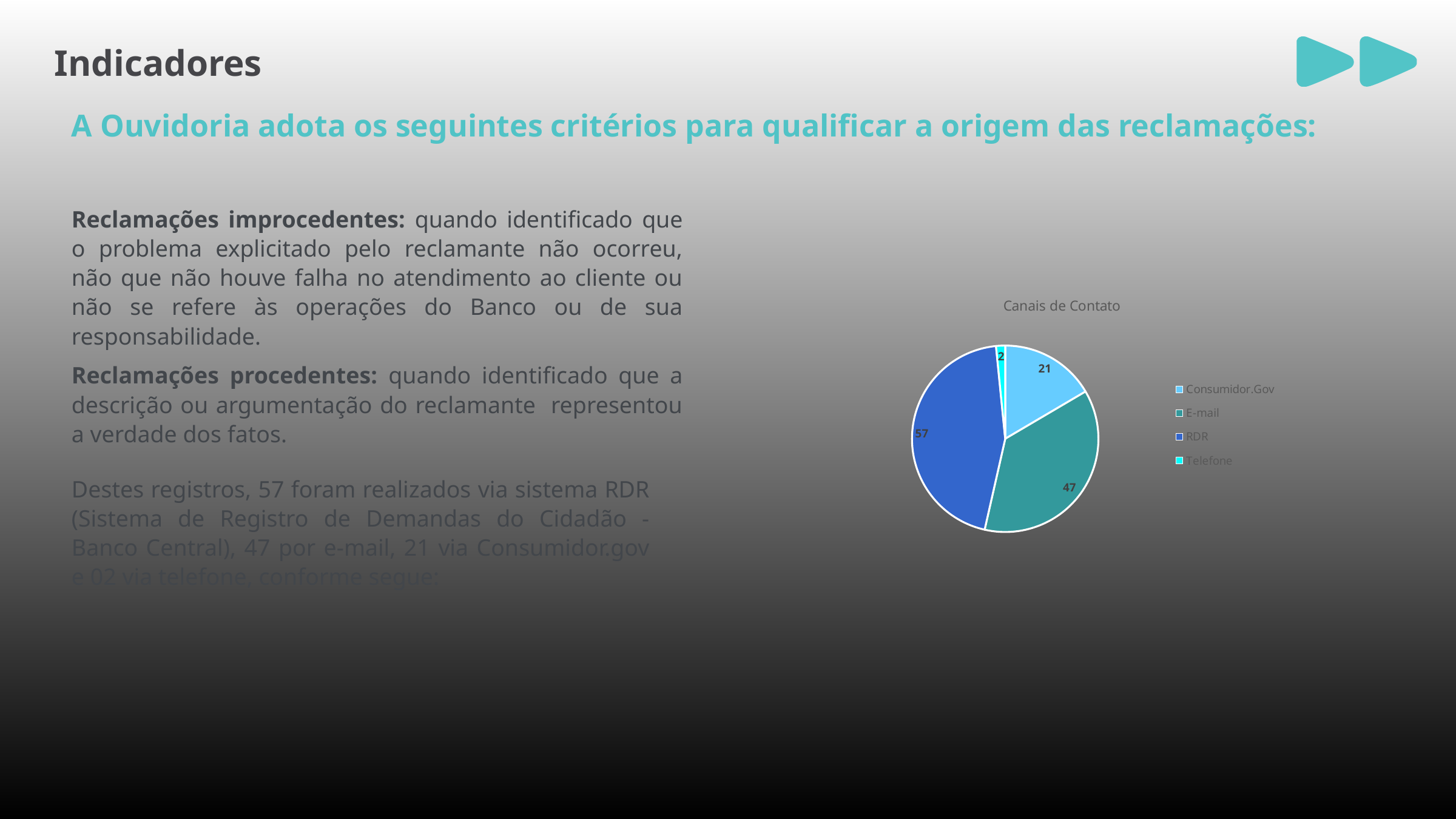
What is the value for RDR in the pie chart? 57 What is the value for Telefone in the pie chart? 2 What is the difference between the values for RDR and E-mail? 10 What is the value for Consumidor.Gov in the pie chart? 21 What is the value for E-mail in the pie chart? 47 What is the total of all slices in the pie chart? 127 What type of chart is shown on the slide? pie chart Which category has the smallest slice in the pie chart? Telefone Which category has the largest slice in the pie chart? RDR How many slices does the pie chart have? 4 Which is larger, the value for E-mail or the value for Consumidor.Gov? E-mail What is the title of the chart? Canais de Contato